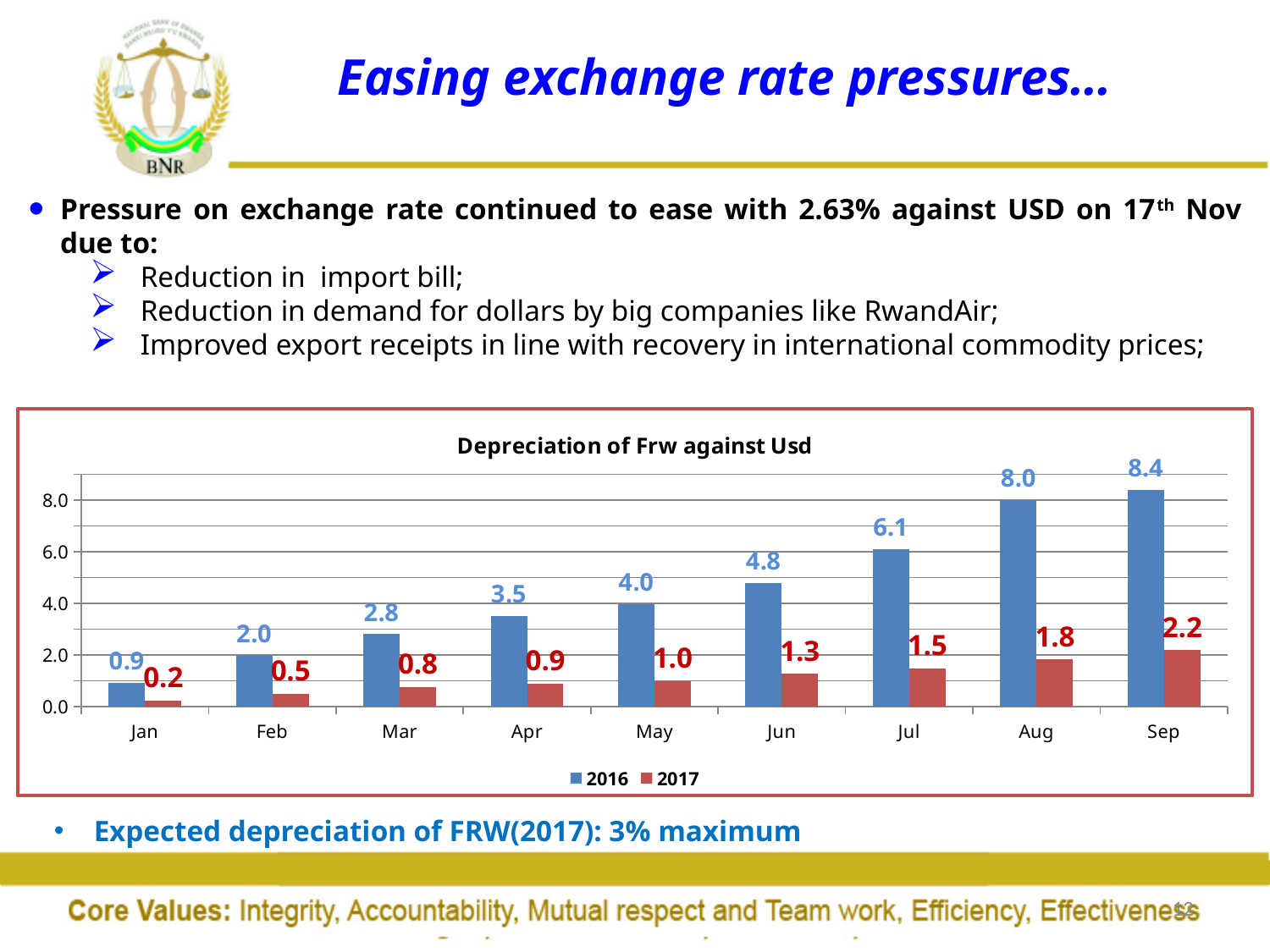
How many series does the legend list? 2 Which month has the lowest 2016 value? Jan What kind of chart is shown on the slide? Bar chart Which month has the highest 2017 value? Sep What is the 2016 value for Apr? 3.5 Do the 2016 values rise or fall from Jan to Sep? Rise What is the 2017 value for Jun? 1.3 Which is larger, the 2016 value for Mar or the 2016 value for May? 2016 value for May What is the difference between the 2016 and 2017 values for Aug? 6.2 What is the 2016 value for Sep in the Depreciation of Frw against Usd chart? 8.4 How many months are shown on the x axis? 9 Is the 2016 value for Jul greater or less than 6.0? greater